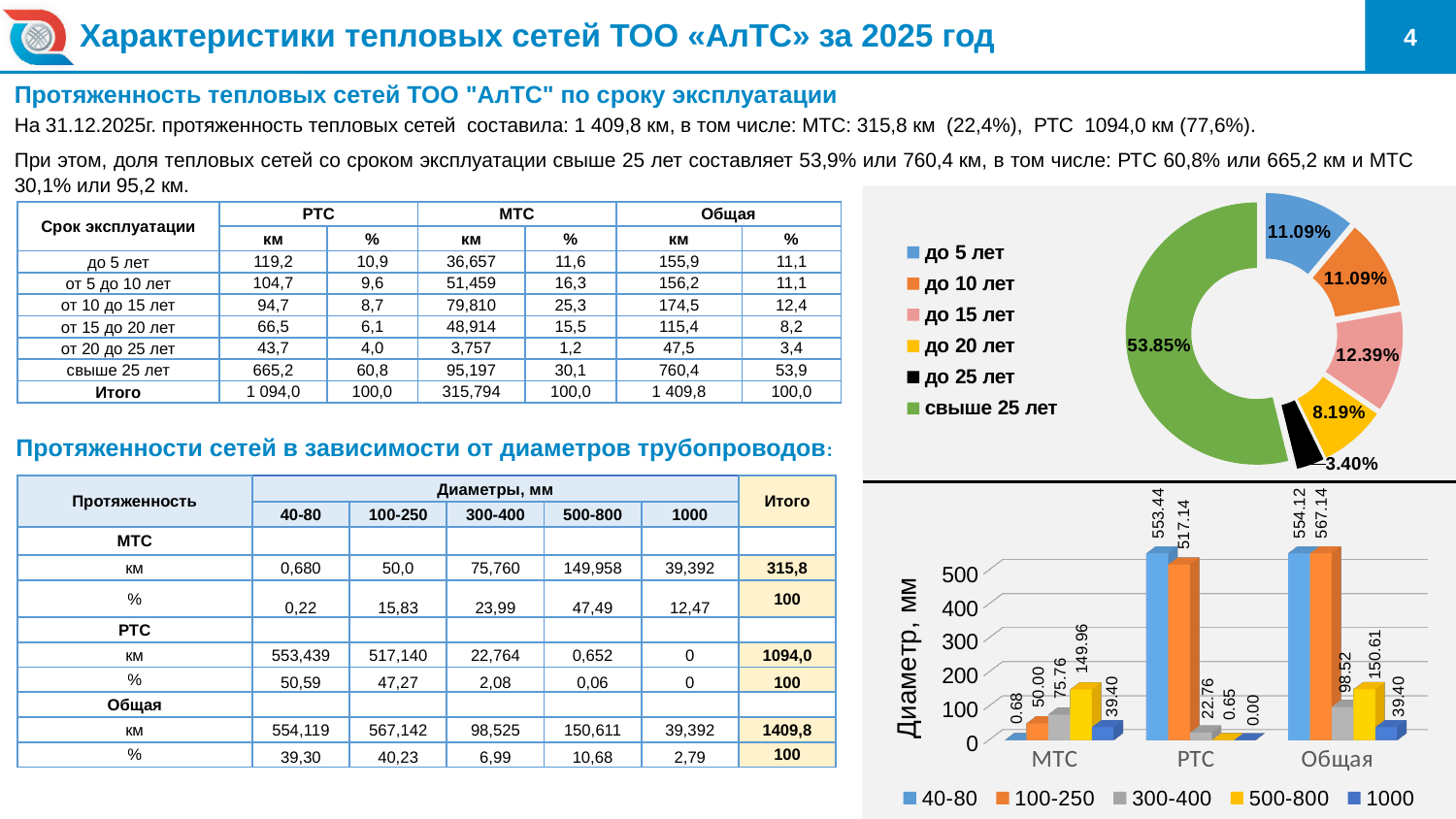
In the doughnut chart on the top right, which segment has the largest share? свыше 25 лет In the doughnut chart on the top right, what share is shown for the segment 'свыше 25 лет'? 53.85% In the bar chart at the bottom right, what is the value of the '100-250' series for Общая? 567.14 In the bar chart at the bottom right, what is the value of the '40-80' series for РТС? 553.44 What is the y-axis title of the bar chart at the bottom right? Диаметр, мм How many series does the legend of the bar chart at the bottom right list? 5 In the bar chart at the bottom right, what is the difference between the '100-250' values for Общая and РТС? 50.00 In the doughnut chart on the top right, which segment has the smallest share? до 25 лет In the doughnut chart on the top right, what share is shown for the segment 'до 20 лет'? 8.19% How many segments does the doughnut chart on the top right have? 6 In the bar chart at the bottom right, what is the value of the '500-800' series for МТС? 149.96 In the bar chart at the bottom right, which is larger for РТС: the '40-80' series or the '300-400' series? 40-80